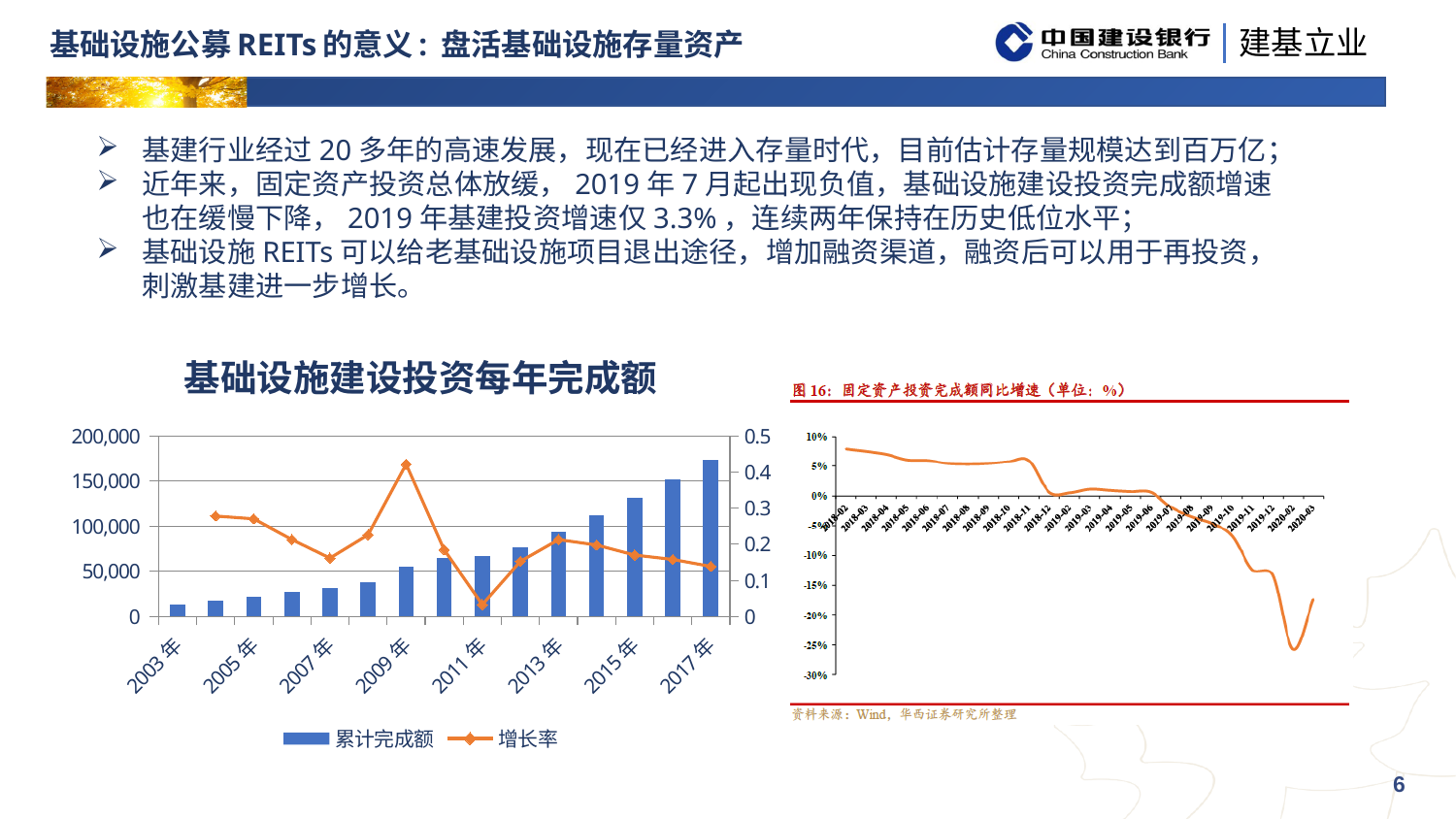
In the left chart 基础设施建设投资每年完成额, in which year does the 增长率 line reach its highest point? 2009年 In the left chart 基础设施建设投资每年完成额, how many series does the legend list? 2 In the left chart 基础设施建设投资每年完成额, which is larger: the 增长率 for 2009年 or for 2011年? 2009年 In the right chart 图16, does the line generally rise or fall from 2018-02 to 2020-03? fall In the left chart 基础设施建设投资每年完成额, do the 累计完成额 bars generally rise or fall from 2003年 to 2017年? rise In the left chart 基础设施建设投资每年完成额, which year has the shortest 累计完成额 bar? 2003年 In the left chart 基础设施建设投资每年完成额, in which year does the 增长率 line reach its lowest point? 2011年 In the left chart 基础设施建设投资每年完成额, which year has the tallest 累计完成额 bar? 2017年 In the left chart 基础设施建设投资每年完成额, is the 增长率 value for 2011年 greater or less than 0.1? less In the left chart 基础设施建设投资每年完成额, is the 累计完成额 value for 2017年 greater or less than 150,000? greater What type of chart is the left chart titled 基础设施建设投资每年完成额? Combined bar and line chart What is the title of the right chart? 图16: 固定资产投资完成额同比增速（单位：%）